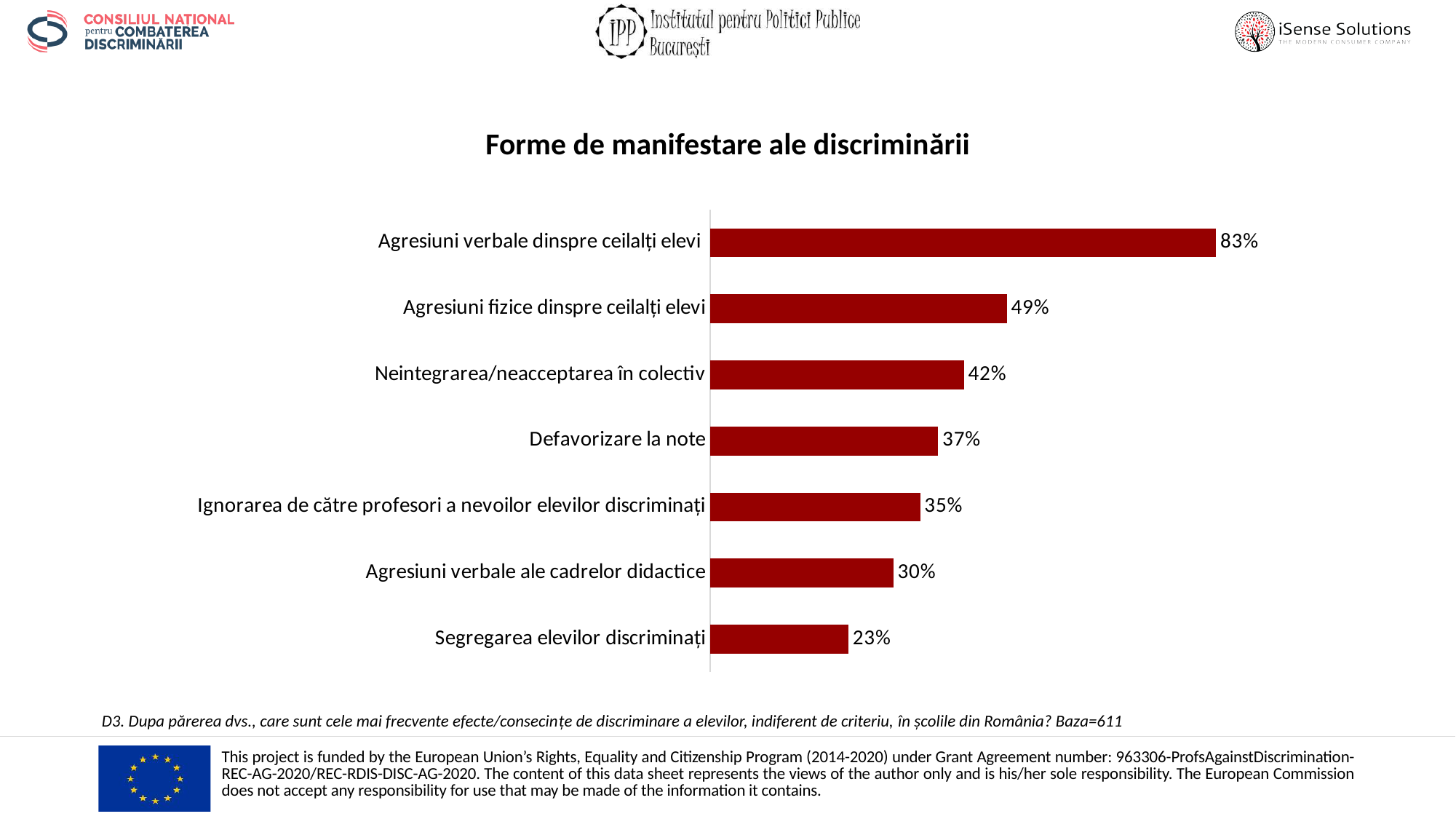
What kind of chart is shown on the slide? Bar chart What is the value for "Defavorizare la note"? 37% Which category has the lowest value? Segregarea elevilor discriminați How many categories are shown in the chart? 7 What is the difference between "Agresiuni verbale dinspre ceilalți elevi" and "Agresiuni fizice dinspre ceilalți elevi"? 34% What is the title of the chart? Forme de manifestare ale discriminării Which category has the highest value? Agresiuni verbale dinspre ceilalți elevi What is the value for "Agresiuni verbale dinspre ceilalți elevi"? 83% What colour are the bars in the chart? Dark red What is the difference between "Neintegrarea/neacceptarea în colectiv" and "Agresiuni verbale ale cadrelor didactice"? 12% Which is larger: "Ignorarea de către profesori a nevoilor elevilor discriminați" or "Agresiuni verbale ale cadrelor didactice"? Ignorarea de către profesori a nevoilor elevilor discriminați What is the value for "Segregarea elevilor discriminați"? 23%